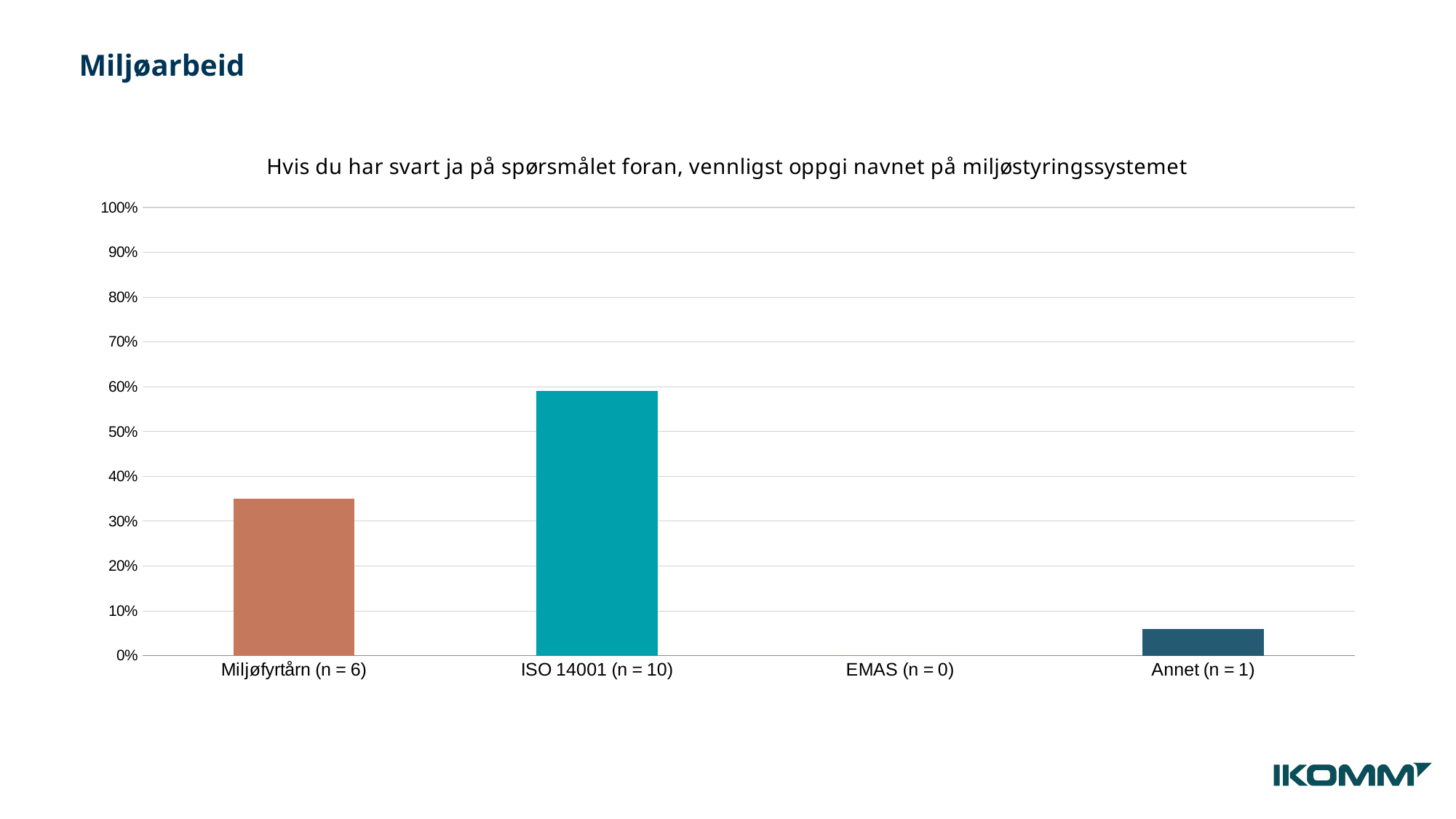
Is the value for Annet greater or less than 10%? less What kind of chart is shown on the slide? bar chart Is the value for Miljøfyrtårn greater or less than 30%? greater Which category has the lowest value in the chart? EMAS (n = 0) What is the value shown for EMAS in the chart? 0% Is the value for ISO 14001 greater or less than 50%? greater How many categories are shown on the x axis of the chart? 4 What is the title of the chart? Hvis du har svart ja på spørsmålet foran, vennligst oppgi navnet på miljøstyringssystemet Which category has the highest bar in the chart? ISO 14001 (n = 10) Which is larger, the value for Miljøfyrtårn or the value for Annet? Miljøfyrtårn Which is larger, the value for ISO 14001 or the value for Miljøfyrtårn? ISO 14001